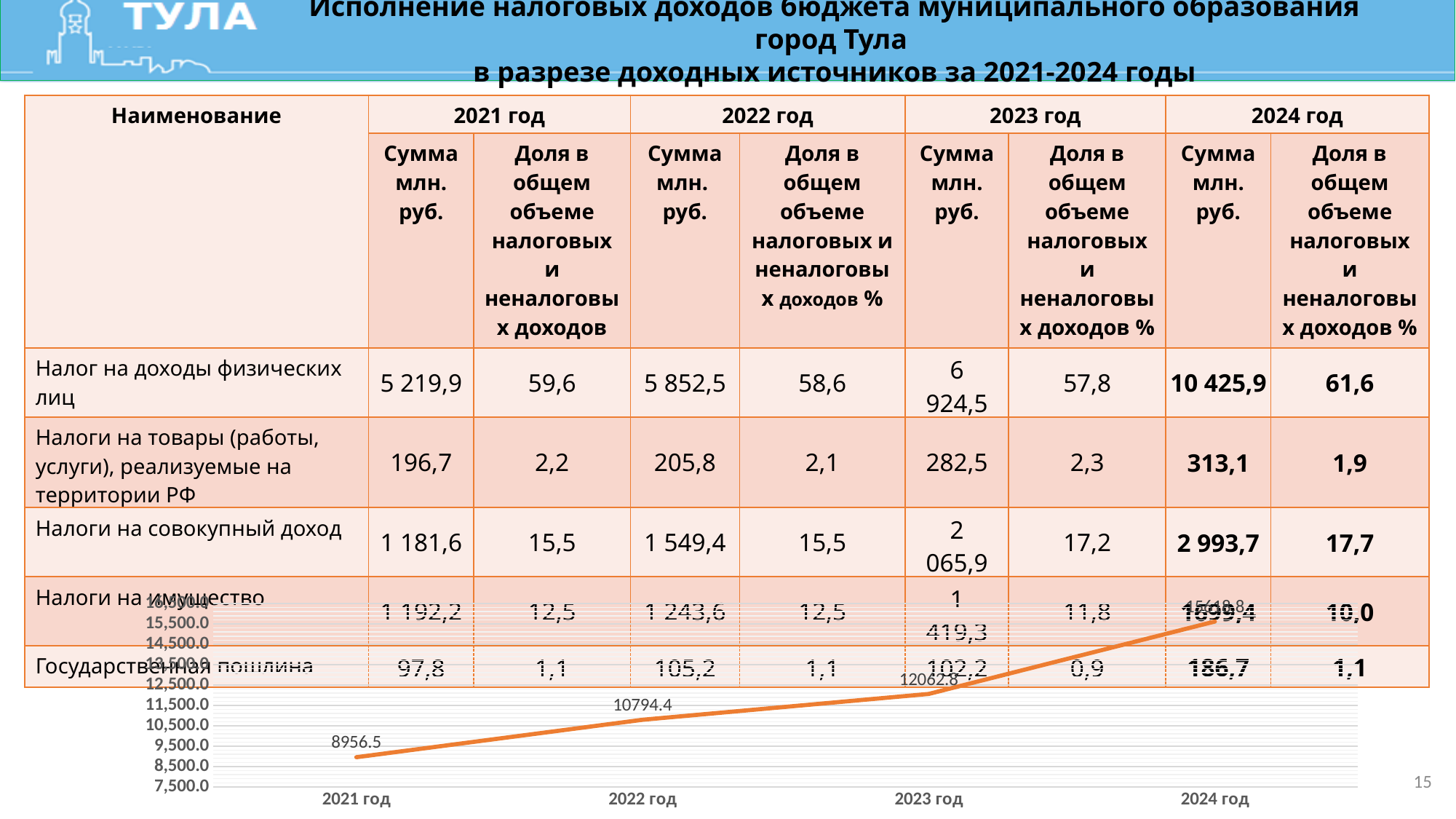
Do the values on the line chart rise or fall from 2021 год to 2024 год? rise What is the value plotted for 2021 год on the line chart? 8956.5 What kind of chart is shown at the bottom of the slide? line chart Which year has the highest value on the line chart? 2024 год Which year has the lowest value on the line chart? 2021 год What is the value plotted for 2022 год on the line chart? 10794.4 What is the value plotted for 2023 год on the line chart? 12062.8 What colour is the line on the line chart? orange How many data points are plotted on the line chart? 4 On the line chart, what is the difference between the values for 2023 год and 2022 год? 1268.4 On the line chart, what is the difference between the values for 2022 год and 2021 год? 1837.9 On the line chart, is the value for 2024 год greater or less than 14,500.0? greater